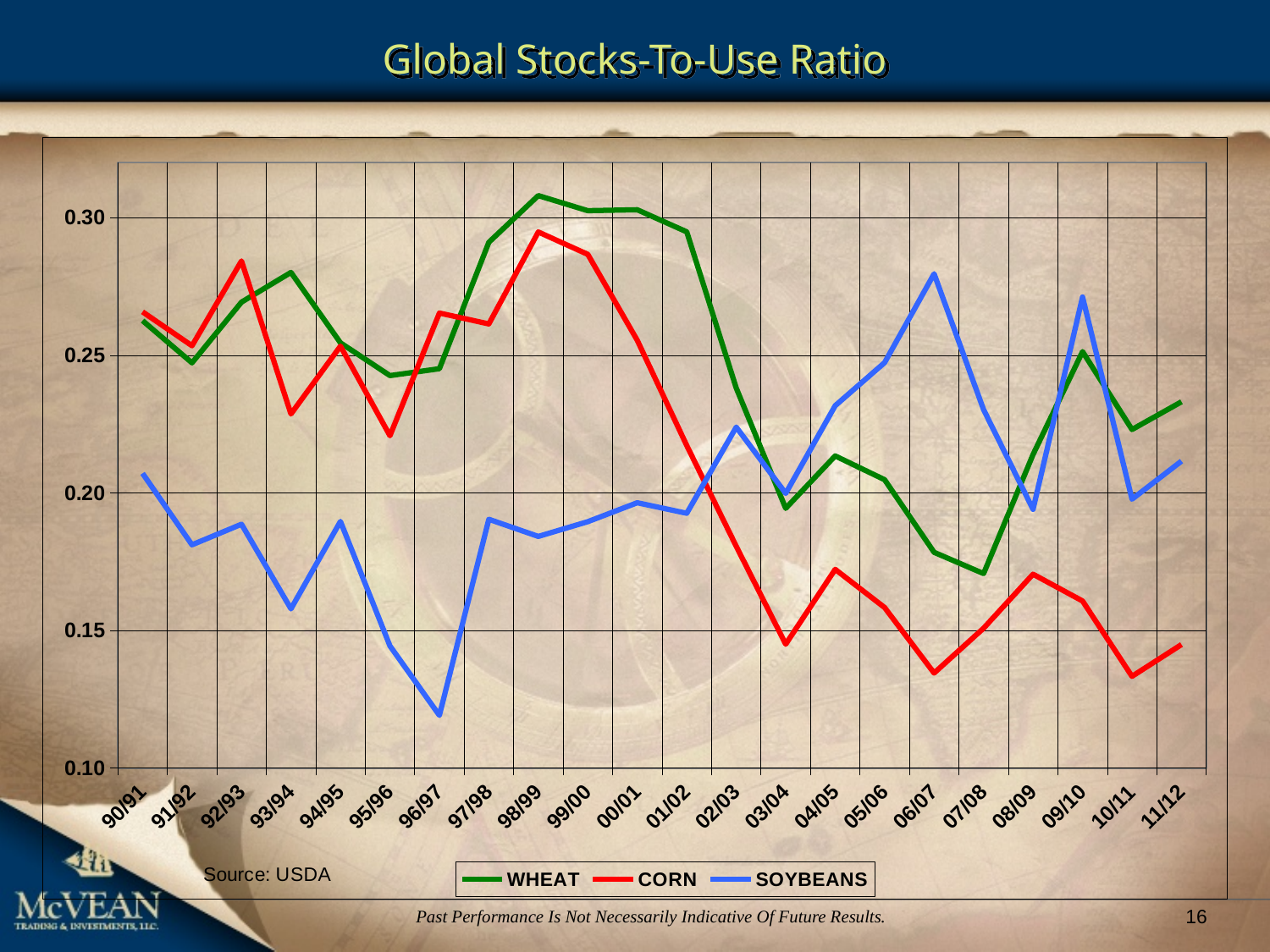
How many marketing years are plotted along the x axis? 22 Which series has the highest value in 06/07? SOYBEANS In 03/04, which is larger, the WHEAT value or the CORN value? WHEAT What kind of chart is shown on the slide? line chart Is the WHEAT value for 98/99 greater or less than 0.30? greater How many series does the legend list? 3 What is the title of the chart? Global Stocks-To-Use Ratio Which colour is used for the WHEAT series? green Which series has the lowest value in 11/12? CORN Does the CORN series rise or fall from 99/00 to 03/04? fall Is the SOYBEANS value for 96/97 greater or less than 0.15? less Is the CORN value for 92/93 greater or less than 0.25? greater